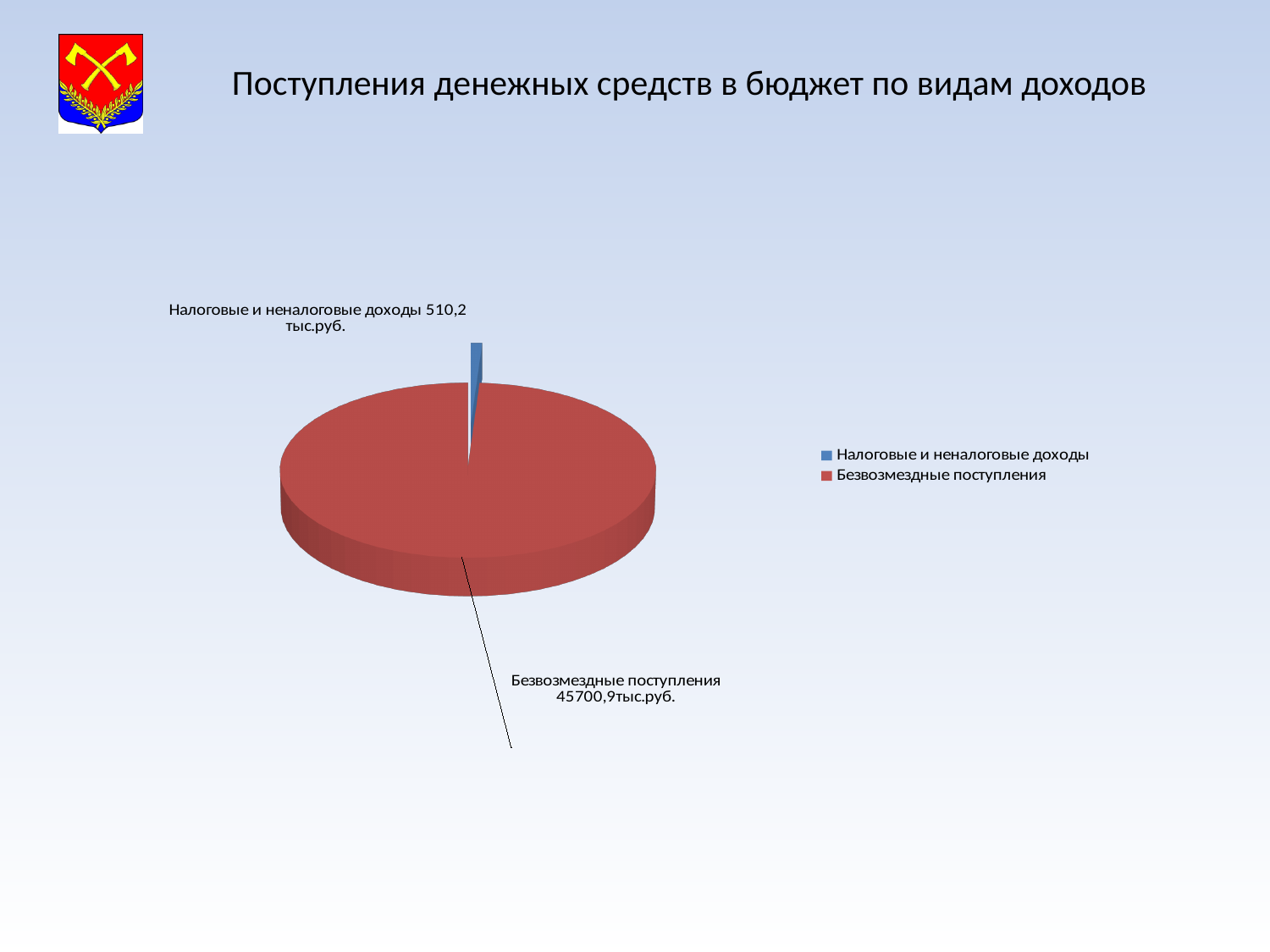
Which category has the largest slice of the pie? Безвозмездные поступления What is the difference between Безвозмездные поступления and Налоговые и неналоговые доходы? 45190,7 тыс.руб. Which category has the smallest slice of the pie? Налоговые и неналоговые доходы What kind of chart is shown on the slide? Pie chart What is the value for Налоговые и неналоговые доходы? 510,2 тыс.руб. What is the value for Безвозмездные поступления? 45700,9 тыс.руб. How many entries does the legend list? 2 What is the title of the slide? Поступления денежных средств в бюджет по видам доходов How many slices does the pie chart have? 2 Which is larger: Безвозмездные поступления or Налоговые и неналоговые доходы? Безвозмездные поступления What colour is the slice for Безвозмездные поступления? Red What is the total of the two slices in the pie? 46211,1 тыс.руб.